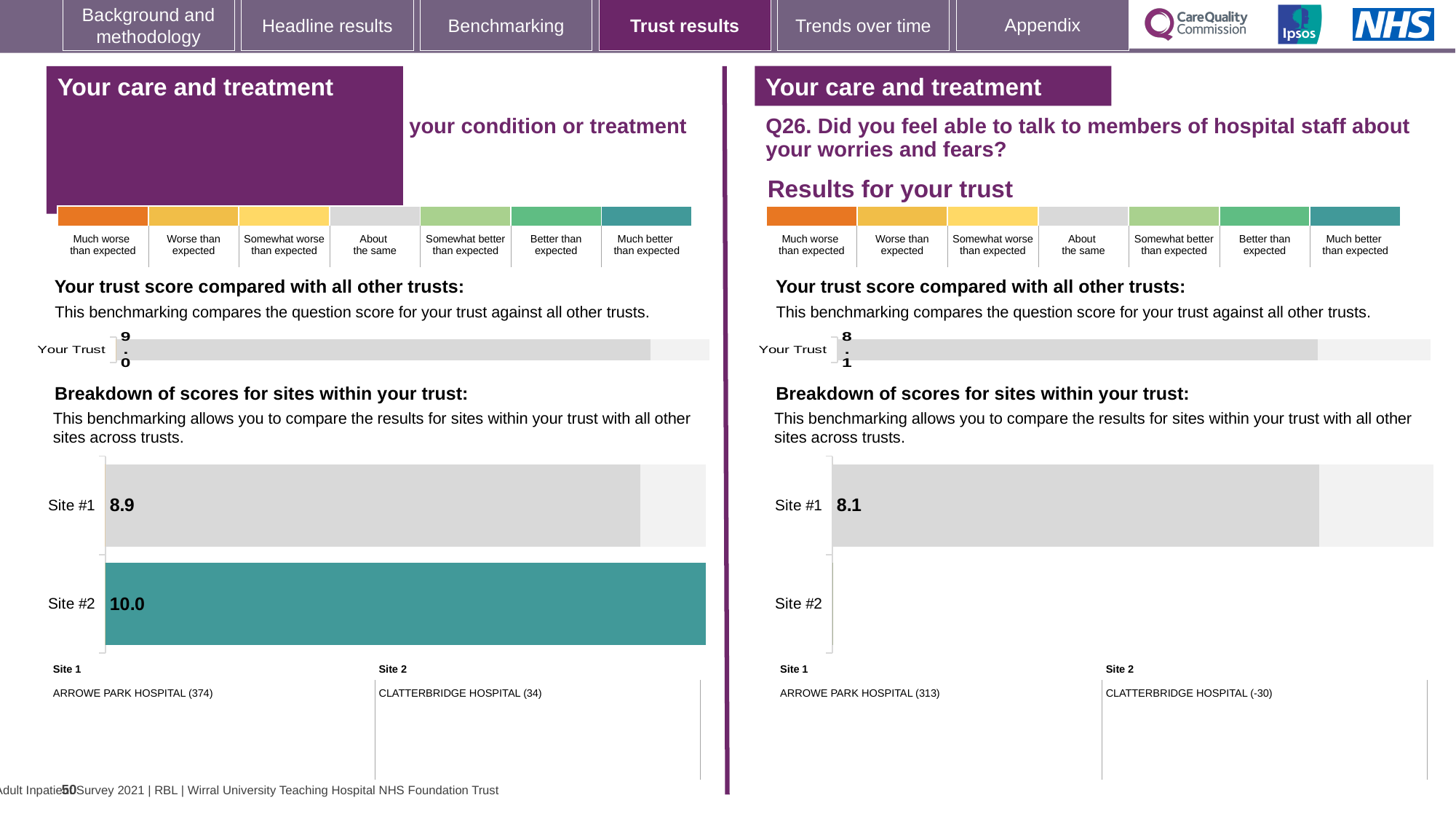
What type of chart is the left-hand site breakdown chart? Bar chart On the left-hand site breakdown chart, what colour is the bar for Site #2? Teal On the left-hand site breakdown chart, what is the score for Site #2? 10.0 On the right-hand (Q26) 'Your trust score compared with all other trusts' chart, what is the score shown for Your Trust? 8.1 On the left-hand site breakdown chart, what is the difference between the Site #2 and Site #1 scores? 1.1 How many sites are listed on the left-hand site breakdown chart? 2 On the left-hand site breakdown chart, which site has the higher score? Site #2 On the left-hand site breakdown chart, what is the score for Site #1? 8.9 On the left-hand 'Your trust score compared with all other trusts' chart, what is the score shown for Your Trust? 9.0 On the left-hand site breakdown chart, which site has the lower score? Site #1 Is the Site #1 score on the left-hand site breakdown chart larger or smaller than the Site #1 score on the right-hand (Q26) site breakdown chart? larger On the right-hand (Q26) site breakdown chart, what is the score for Site #1? 8.1